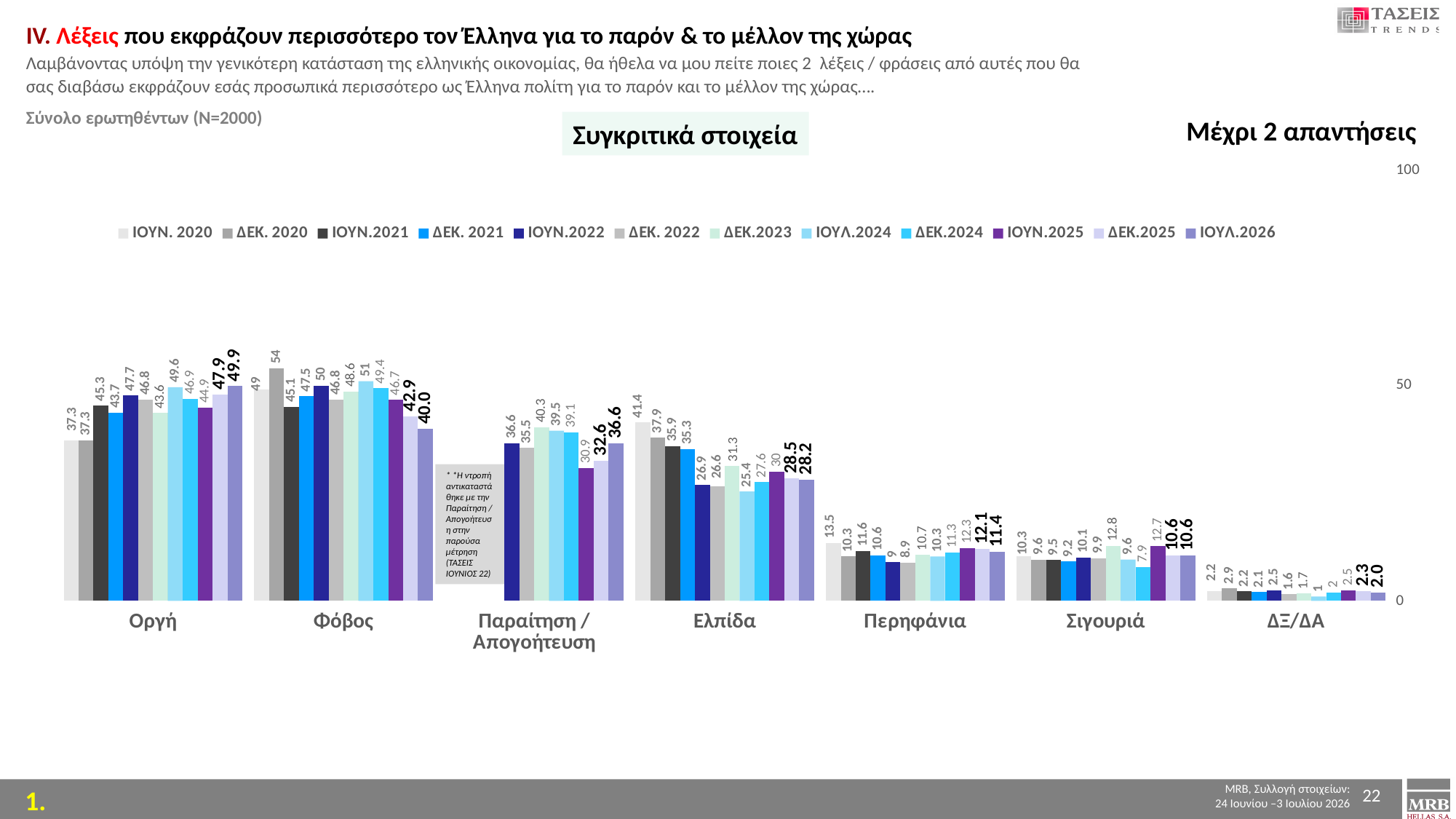
What is the value for Οργή in the ΙΟΥΛ.2026 series? 49.9 For Οργή, what is the difference between the ΙΟΥΛ.2026 value and the ΔΕΚ.2025 value? 2.0 In the ΙΟΥΛ.2026 series, which category has the highest value? Οργή In the ΙΟΥΛ.2026 series, which category has the lowest value? ΔΞ/ΔΑ In the ΙΟΥΛ.2026 series, which is larger: the value for Οργή or the value for Φόβος? Οργή For Φόβος, do the values rise or fall across the last three series (ΙΟΥΝ.2025, ΔΕΚ.2025, ΙΟΥΛ.2026)? Fall What is the value for Ελπίδα in the ΔΕΚ.2025 series? 28.5 What is the value for Φόβος in the ΙΟΥΛ.2026 series? 40.0 How many categories are shown on the x axis of the chart? 7 How many series does the legend list? 12 What kind of chart is shown on the slide? Bar chart What is the value for Φόβος in the ΔΕΚ. 2020 series? 54